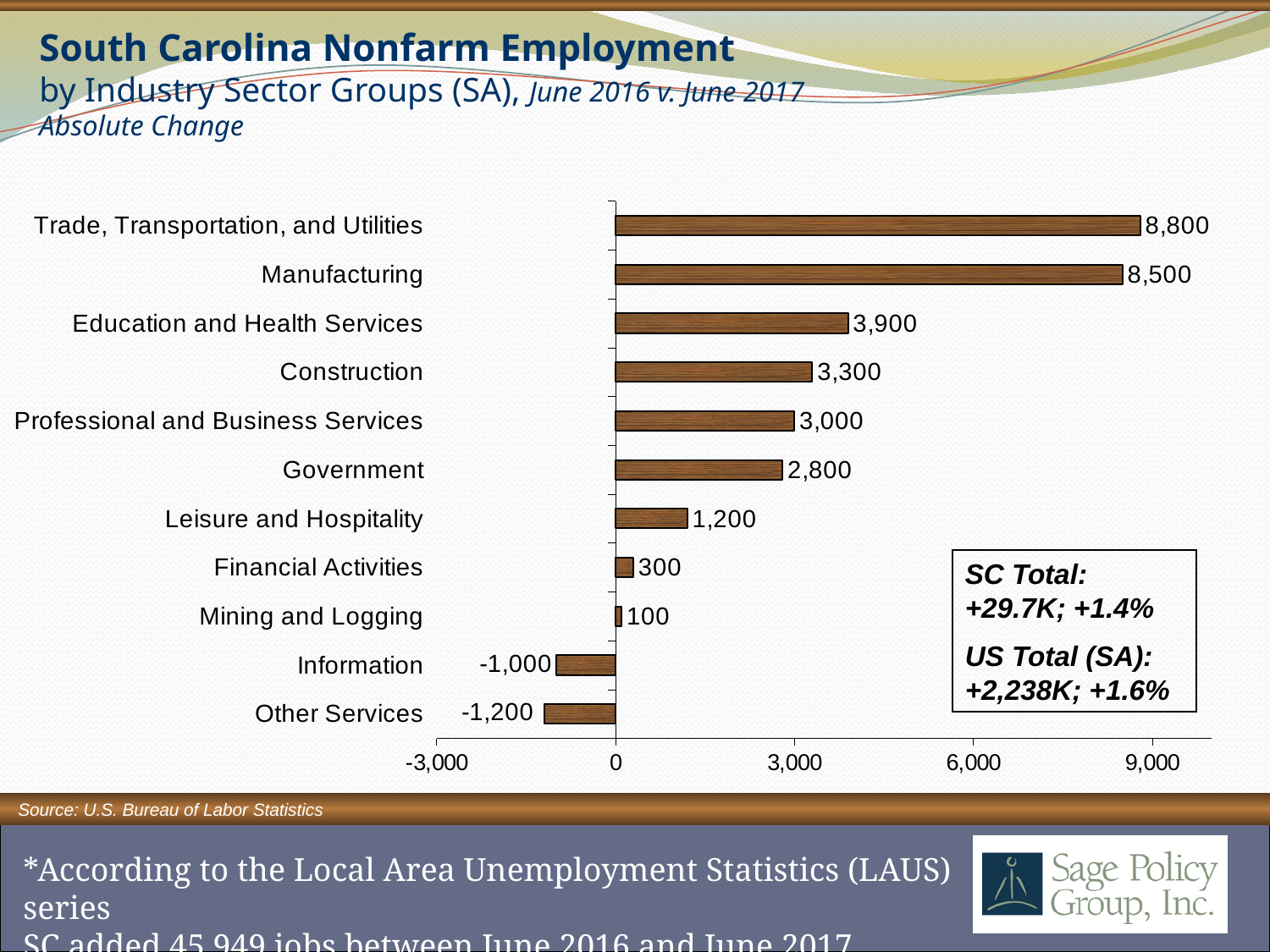
What is the absolute change in employment for Government? 2,800 Which has a larger absolute change, Professional and Business Services or Leisure and Hospitality? Professional and Business Services What is the absolute change in employment for Information? -1,000 What is the SC Total absolute change shown in the text box on the chart? +29.7K; +1.4% How many industry sector groups are shown in the chart? 11 What is the difference between the absolute change for Trade, Transportation, and Utilities and for Manufacturing? 300 How many industry sector groups show a negative absolute change? 2 Which industry sector group has the lowest absolute change? Other Services What kind of chart is shown on the slide? Bar chart What is the difference between the absolute change for Education and Health Services and for Construction? 600 What is the absolute change in employment for Manufacturing? 8,500 Which industry sector group has the highest absolute change? Trade, Transportation, and Utilities